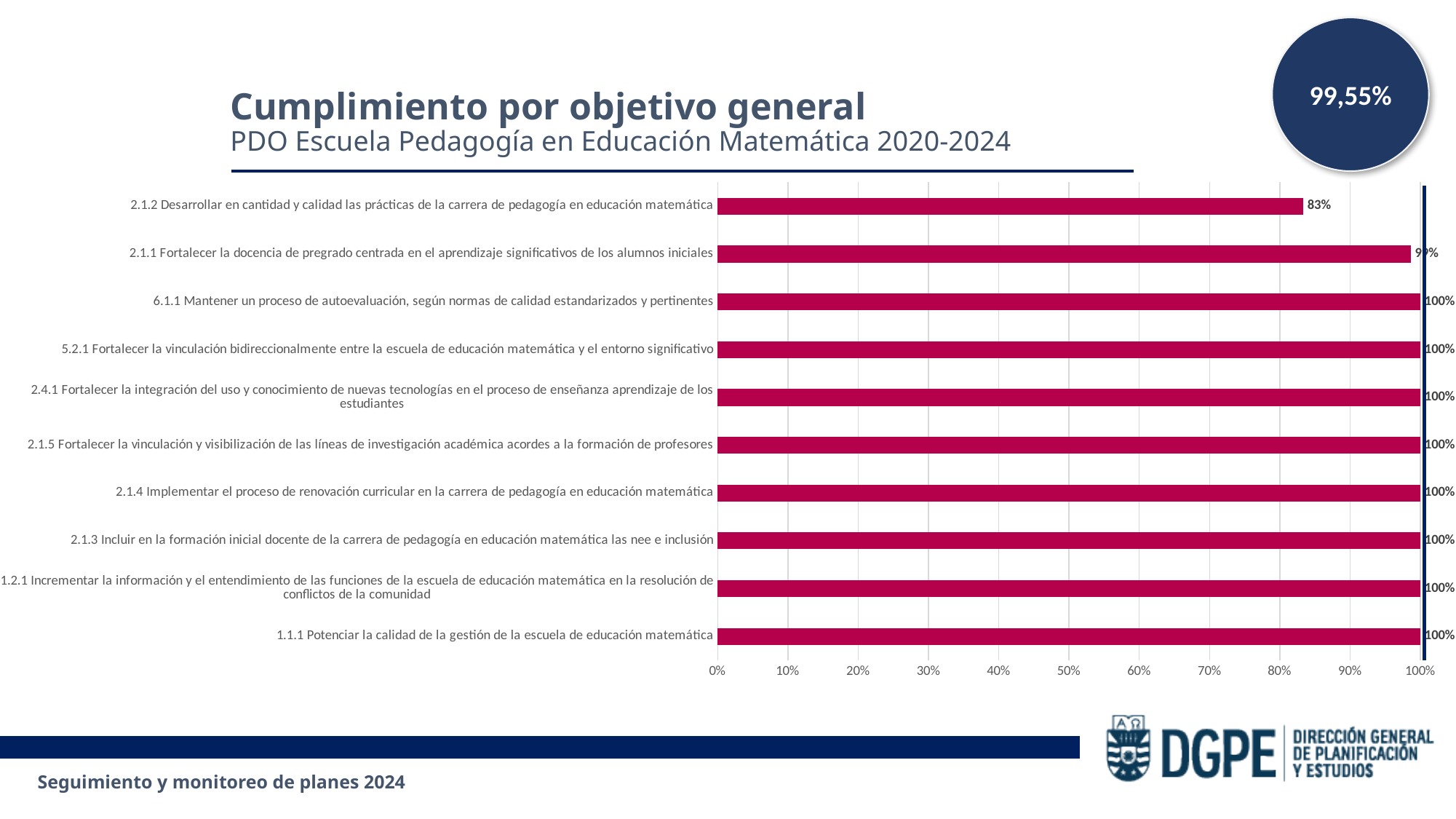
Which is larger: the value for objective 2.1.2 or the value for objective 2.1.3? 2.1.3 What is the difference between the value for objective 1.1.1 and the value for objective 2.1.2? 17% What type of chart is shown on the slide? bar chart What is the value for objective 2.1.2 Desarrollar en cantidad y calidad las prácticas de la carrera de pedagogía en educación matemática? 83% What is the title of the chart? Cumplimiento por objetivo general How many objectives (categories) are plotted in the chart? 10 Which objective has the lowest value in the chart? 2.1.2 Desarrollar en cantidad y calidad las prácticas de la carrera de pedagogía en educación matemática What is the value for objective 1.1.1 Potenciar la calidad de la gestión de la escuela de educación matemática? 100% Is the value for objective 2.1.1 Fortalecer la docencia de pregrado centrada en el aprendizaje significativos de los alumnos iniciales greater or less than 90%? greater Is the value for objective 2.1.2 greater or less than 90%? less What is the value for objective 6.1.1 Mantener un proceso de autoevaluación, según normas de calidad estandarizados y pertinentes? 100% How many objectives have a value of 100%? 8